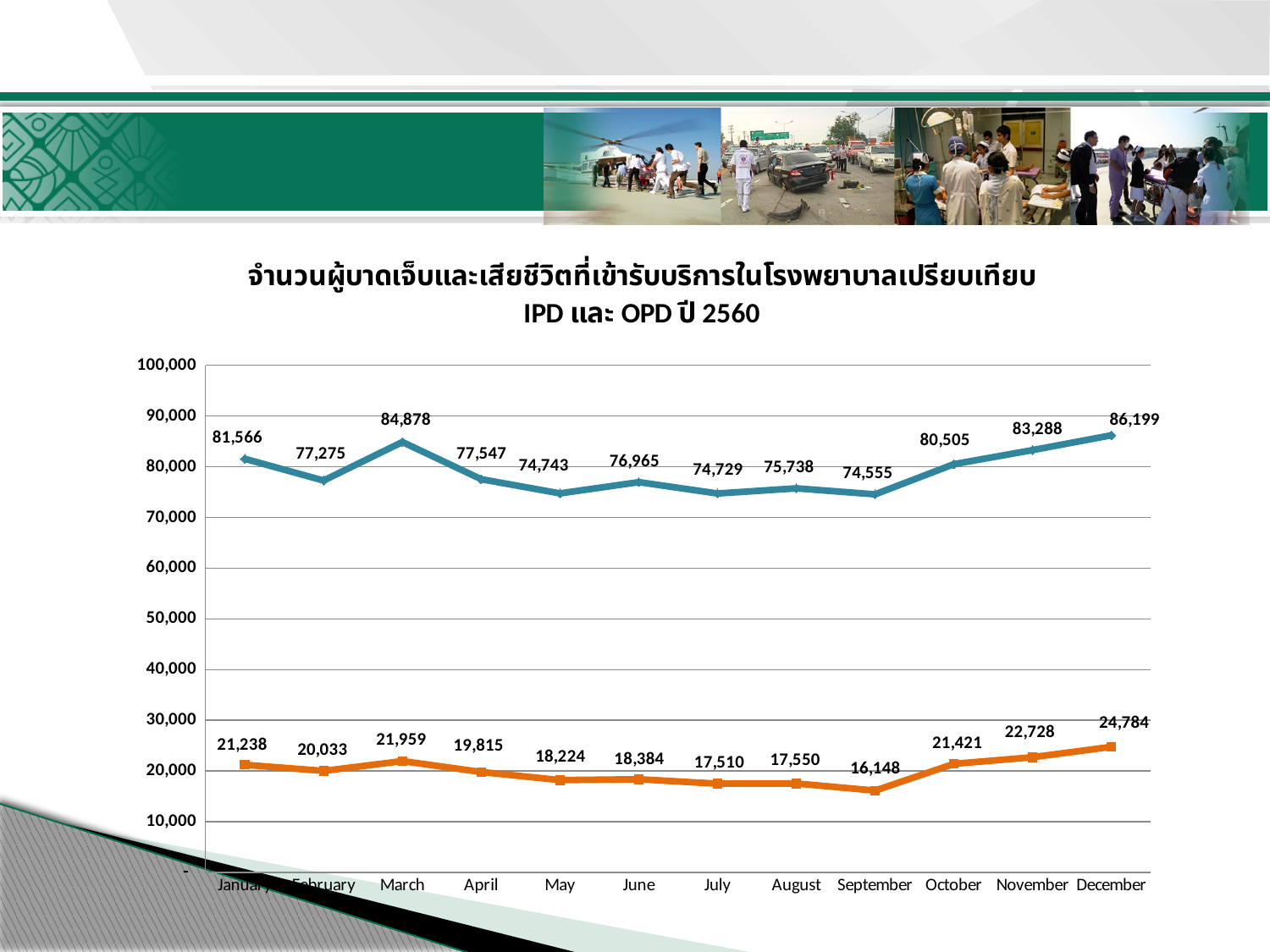
Which is larger for the upper (blue) line: the value for March or the value for February? March How many months are plotted along the x axis of the chart? 12 What is the value of the upper (blue) line for March? 84,878 From September to December, do the values of the lower (orange) line rise or fall? Rise In which month does the upper (blue) line reach its highest value? December What is the value of the upper (blue) line for October? 80,505 In which month does the upper (blue) line reach its lowest value? September In which month does the lower (orange) line reach its lowest value? September What type of chart is shown on the slide? Line chart What is the value of the lower (orange) line for September? 16,148 What is the value of the lower (orange) line for December? 24,784 What is the difference between the upper (blue) line and the lower (orange) line in December? 61,415